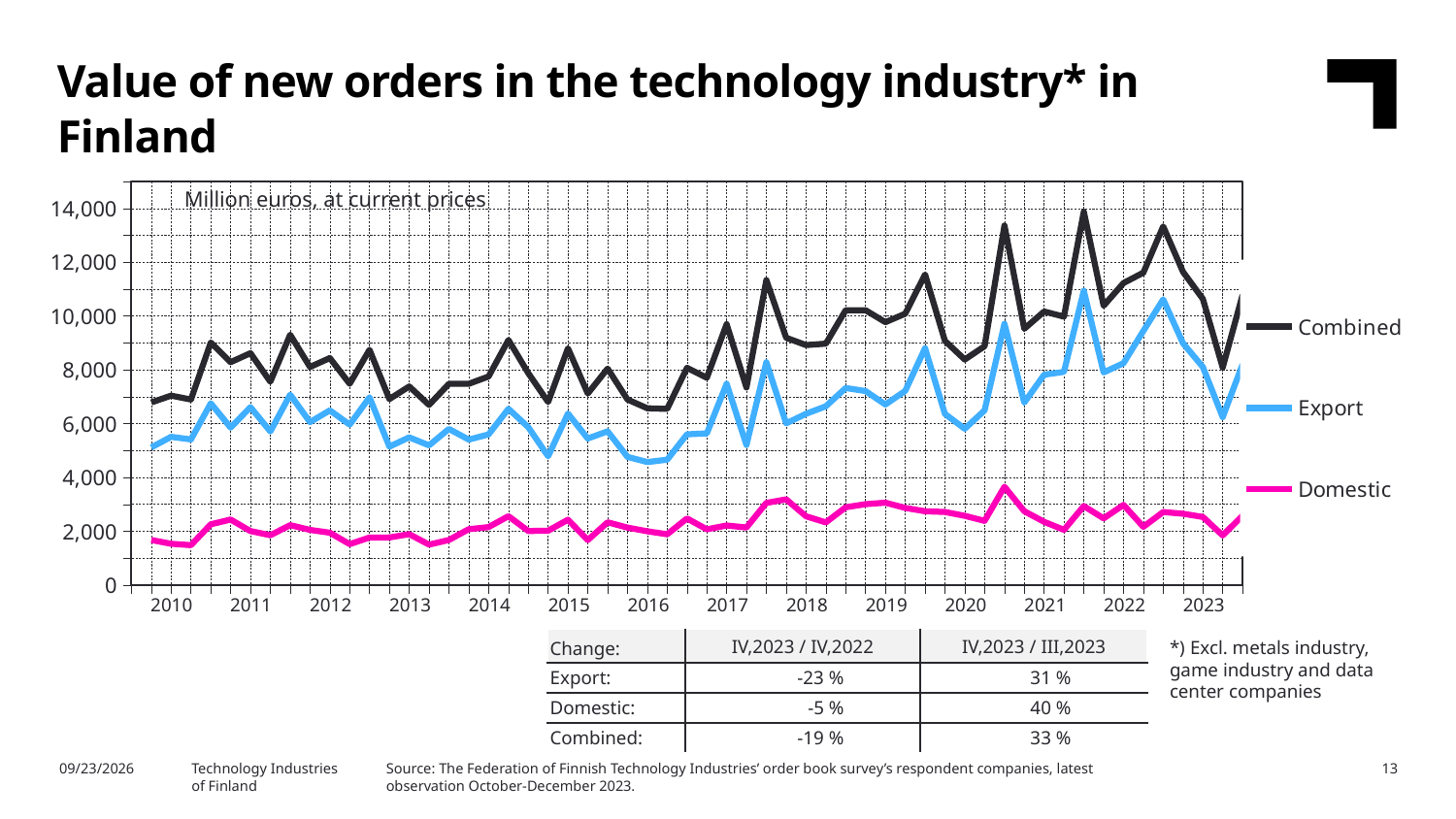
What type of chart is shown on the slide? line chart Which series has the highest values throughout the chart? Combined How many series does the chart's legend list? 3 What are the three series named in the chart legend? Combined, Export, Domestic Which is larger at the end of 2023, the Export series or the Domestic series? Export Is the Domestic series ever greater or less than 4,000 million euros over the whole period? less Overall, does the Combined series rise or fall from 2010 to 2023? rise Is the value of the Combined series at the start of 2010 greater or less than 8,000? less Which series has the lowest values throughout the chart? Domestic How many years are labelled on the x axis of the chart? 14 What unit is stated at the top of the chart area? Million euros, at current prices Is the peak of the Export series in 2021 greater or less than 10,000? greater